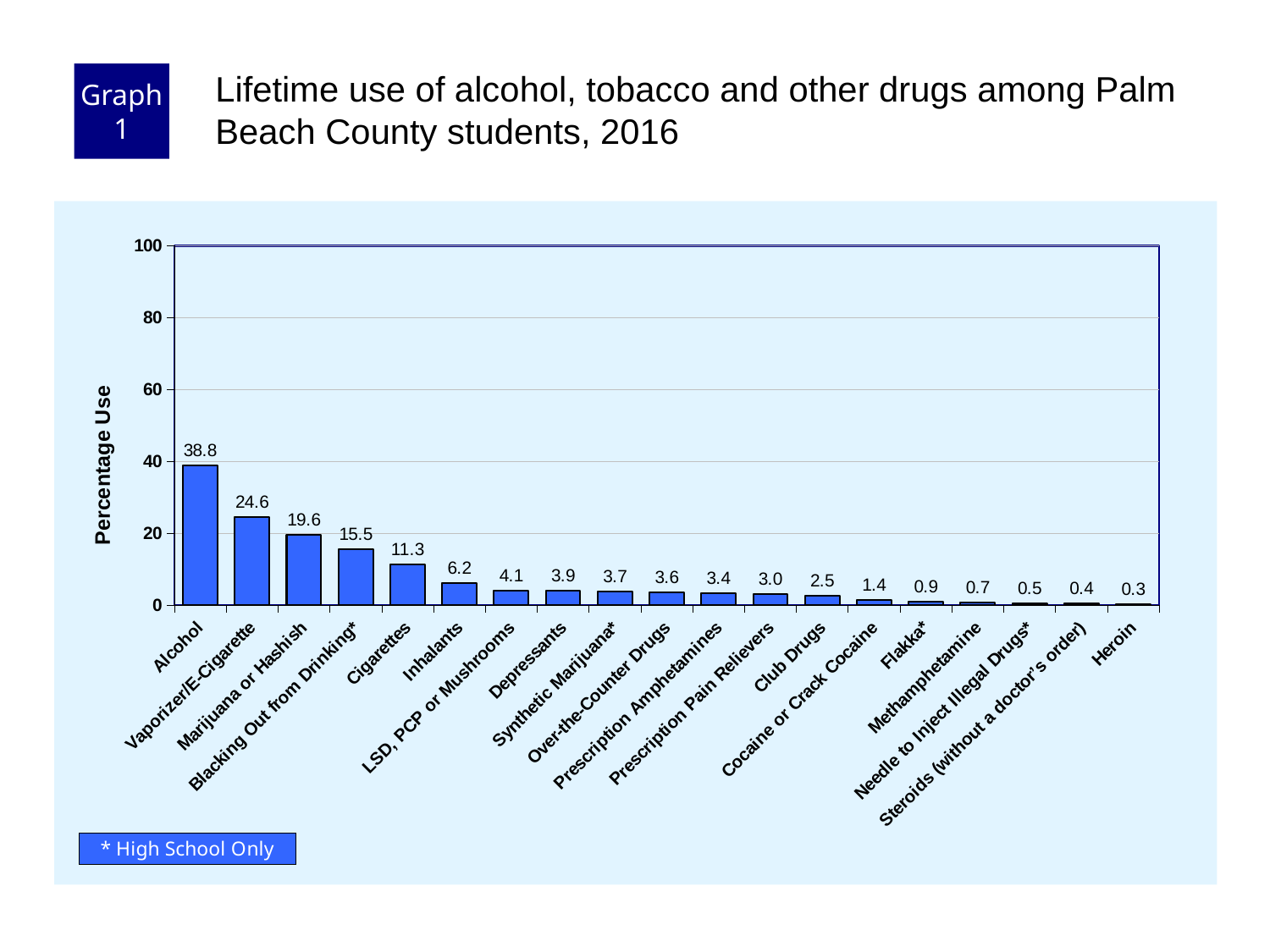
What is the percentage use for Cigarettes? 11.3 Which category has the lowest percentage use? Heroin Is the value for Blacking Out from Drinking* greater or less than 20? less What is the difference in percentage use between Alcohol and Vaporizer/E-Cigarette? 14.2 What kind of chart is shown on the slide? Bar chart Which has a higher percentage use, Inhalants or Depressants? Inhalants What is the difference in percentage use between Marijuana or Hashish and Cigarettes? 8.3 Which category has the highest percentage use? Alcohol How many categories are shown on the x axis? 19 What is the percentage use for Club Drugs? 2.5 What is the percentage use for Alcohol? 38.8 What is the label of the y axis? Percentage Use